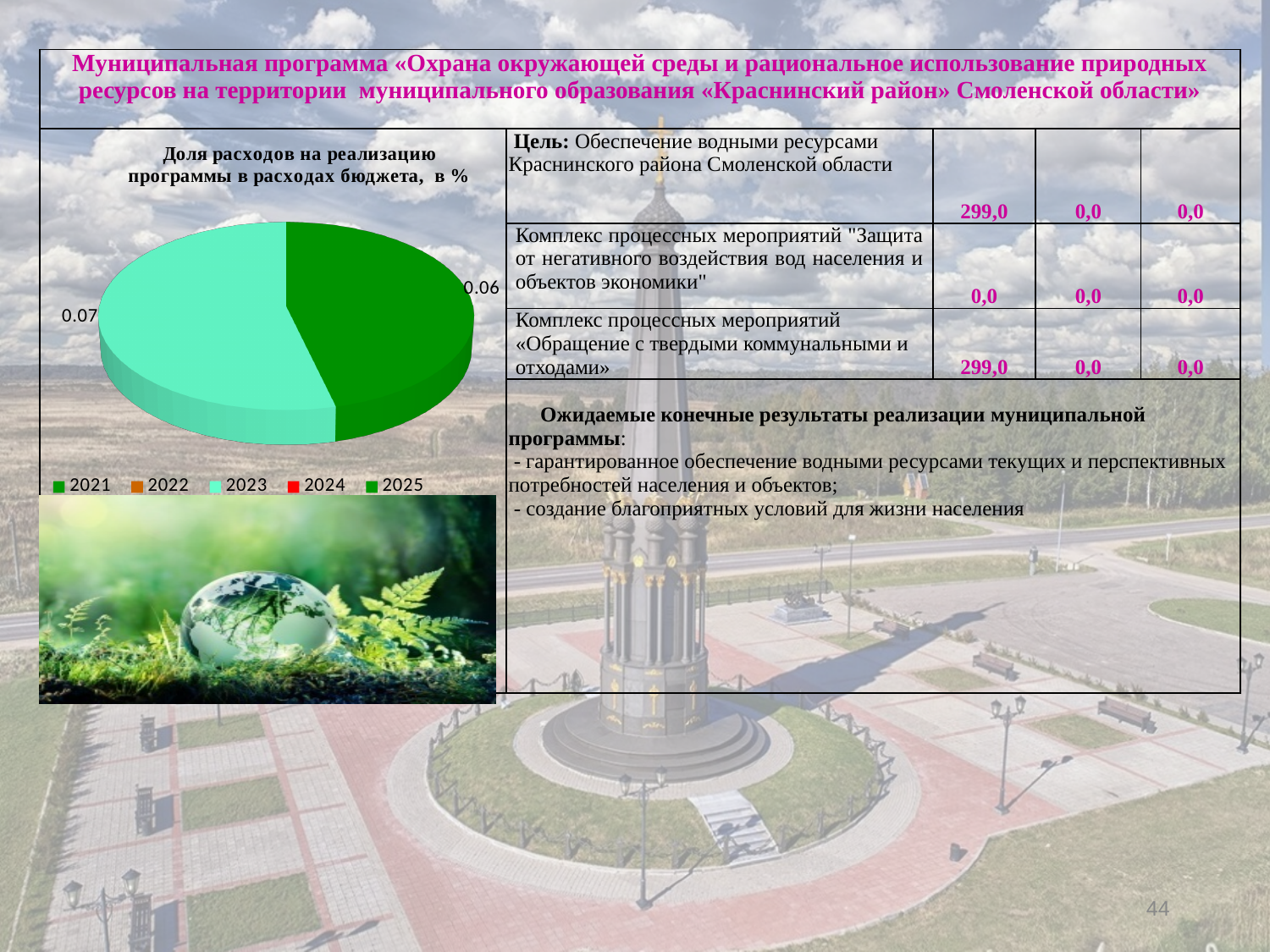
Which labelled slice of the pie chart is larger, the one labelled 0.07 or the one labelled 0.06? 0.07 What is the smallest labelled value on the pie chart? 0.06 What is the difference between the two labelled values on the pie chart, 0.07 and 0.06? 0.01 What is the title of the pie chart? Доля расходов на реализацию программы в расходах бюджета, в % What value is labelled on the light green slice of the pie chart? 0.07 What value is labelled on the dark green slice of the pie chart? 0.06 What is the largest labelled value on the pie chart? 0.07 How many slices with data labels are visible on the pie chart? 2 How many entries does the legend of the pie chart list? 5 Which years are listed in the legend of the pie chart? 2021, 2022, 2023, 2024, 2025 What kind of chart is shown on the left of the slide? pie chart